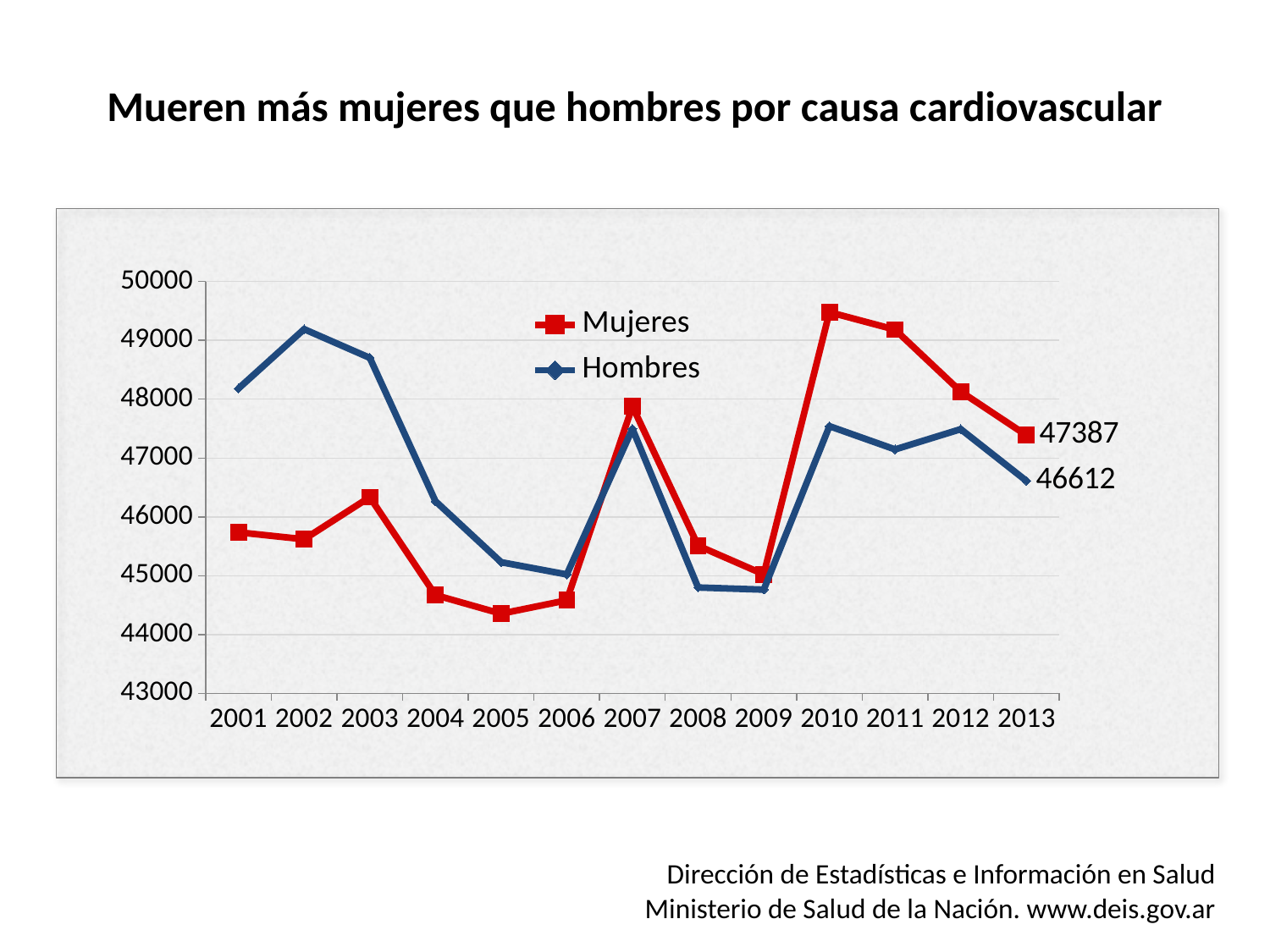
What is the value for Hombres in 2013? 46612 In which year does the Mujeres series reach its highest value? 2010 What is the value for Mujeres in 2013? 47387 In 2013, which series has the larger value, Mujeres or Hombres? Mujeres Is the value for Mujeres in 2004 greater or less than 45000? less What is the difference between the Mujeres and Hombres values in 2013? 775 What kind of chart is shown on the slide? Line chart In which year does the Hombres series reach its highest value? 2002 In which year does the Mujeres series reach its lowest value? 2005 In 2001, which series has the larger value, Mujeres or Hombres? Hombres How many years are shown on the x axis? 13 How many series does the legend list? 2